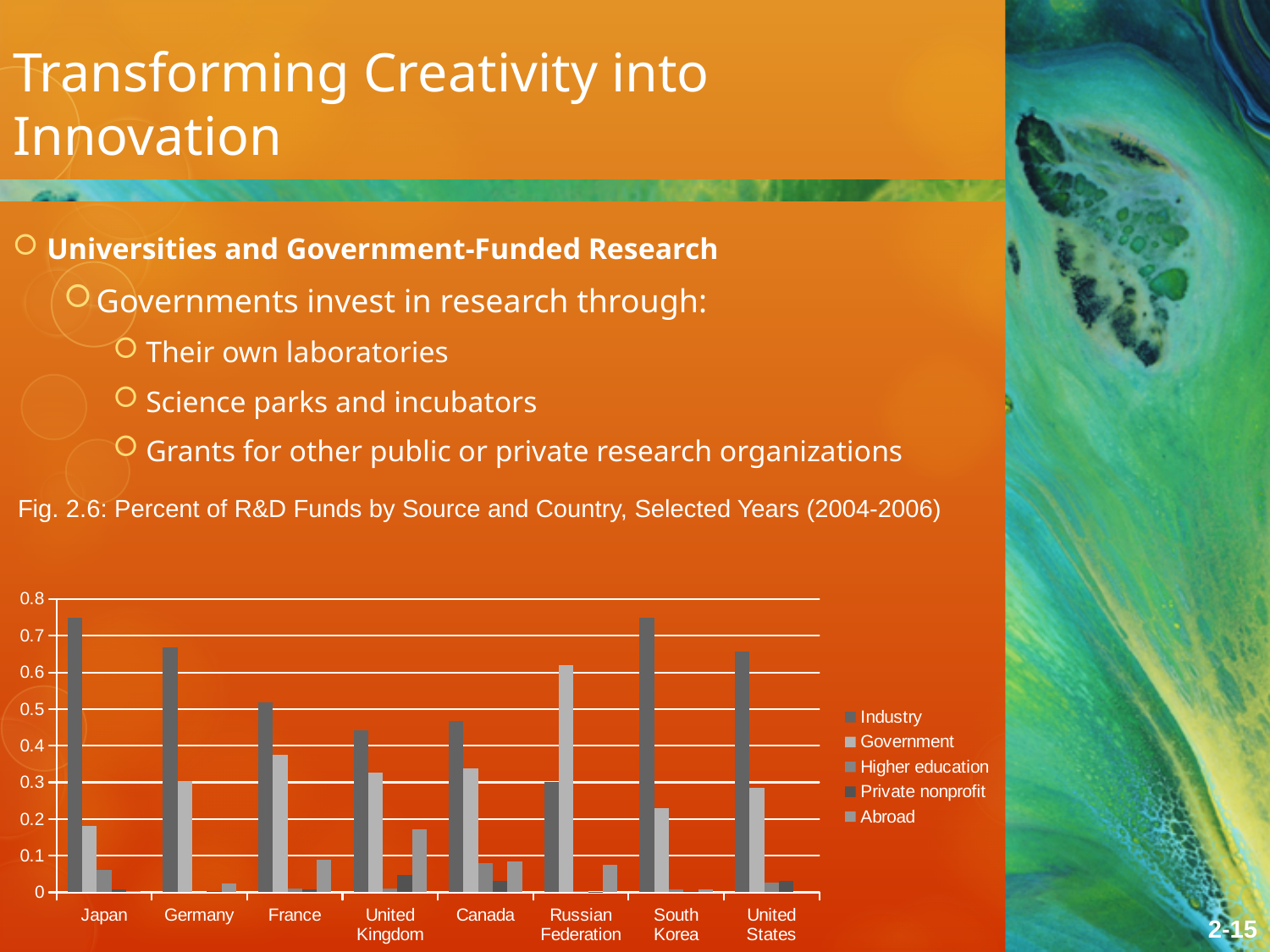
What kind of chart is shown on the slide? Bar chart Is the Industry value for Japan greater or less than 0.7? greater Is the Government value for the Russian Federation greater or less than 0.6? greater Which is larger, the Industry value for Germany or the Industry value for France? Germany What is the title of the figure shown on the slide? Fig. 2.6: Percent of R&D Funds by Source and Country, Selected Years (2004-2006) Which country has the highest Government value in the chart? Russian Federation Which is larger, the Government value for Canada or the Government value for Japan? Canada How many series does the chart's legend list? 5 Which country has the lowest Industry value in the chart? Russian Federation Is the Industry value for the United Kingdom greater or less than 0.5? less Which country has the highest Abroad value in the chart? United Kingdom How many countries are shown on the x axis of the chart? 8